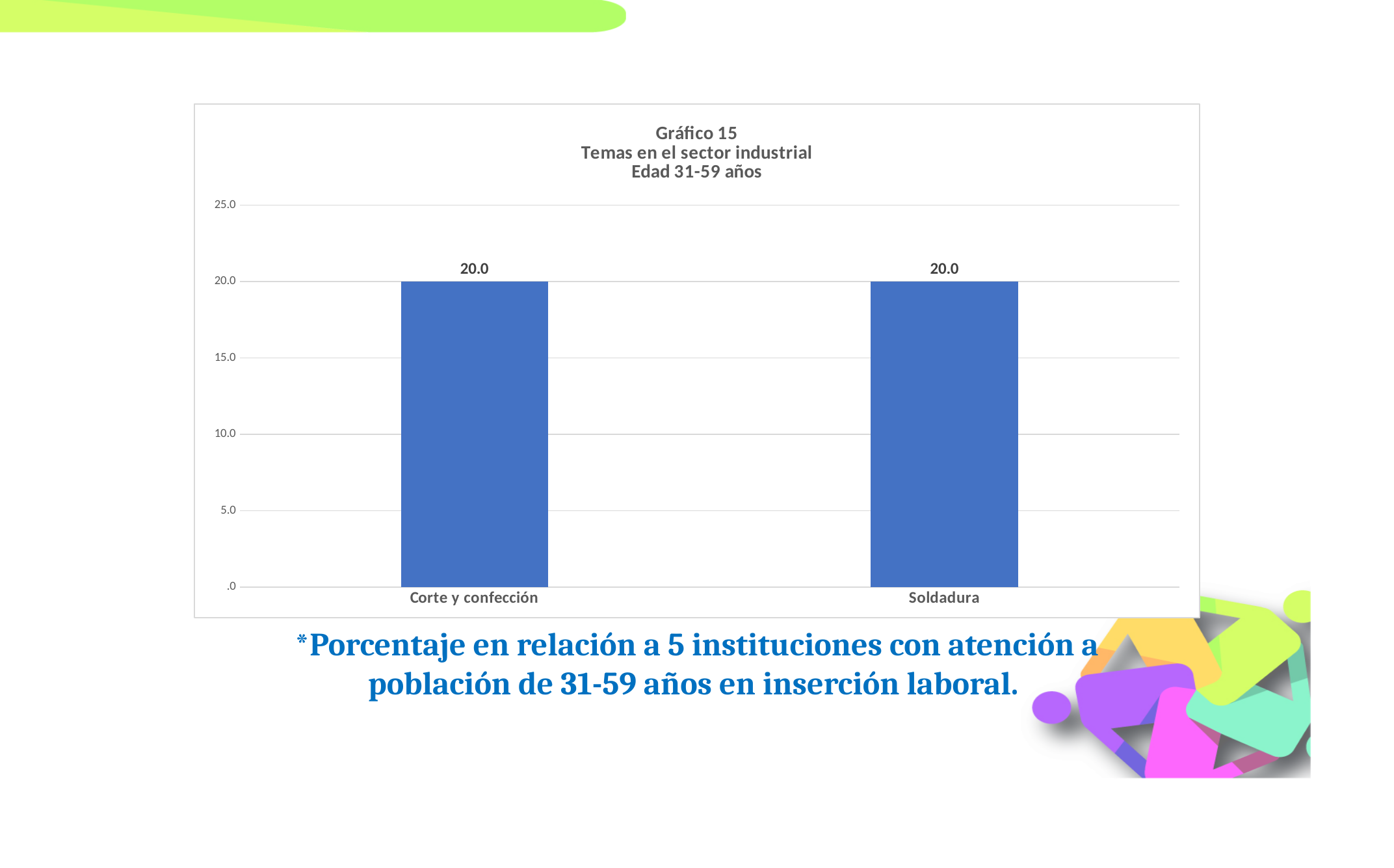
How many categories are shown on the x axis? 2 What is the value for Corte y confección? 20.0 What is the title of the chart? Gráfico 15 Temas en el sector industrial Edad 31-59 años Is the value for Corte y confección greater or less than 25.0? less Is the value for Soldadura greater or less than 15.0? greater What is the difference between the values for Corte y confección and Soldadura? 0.0 What is the highest value shown on the y axis? 25.0 What is the value for Soldadura? 20.0 What kind of chart is shown on the slide? bar chart Do the values rise, fall or stay the same from Corte y confección to Soldadura? stay the same